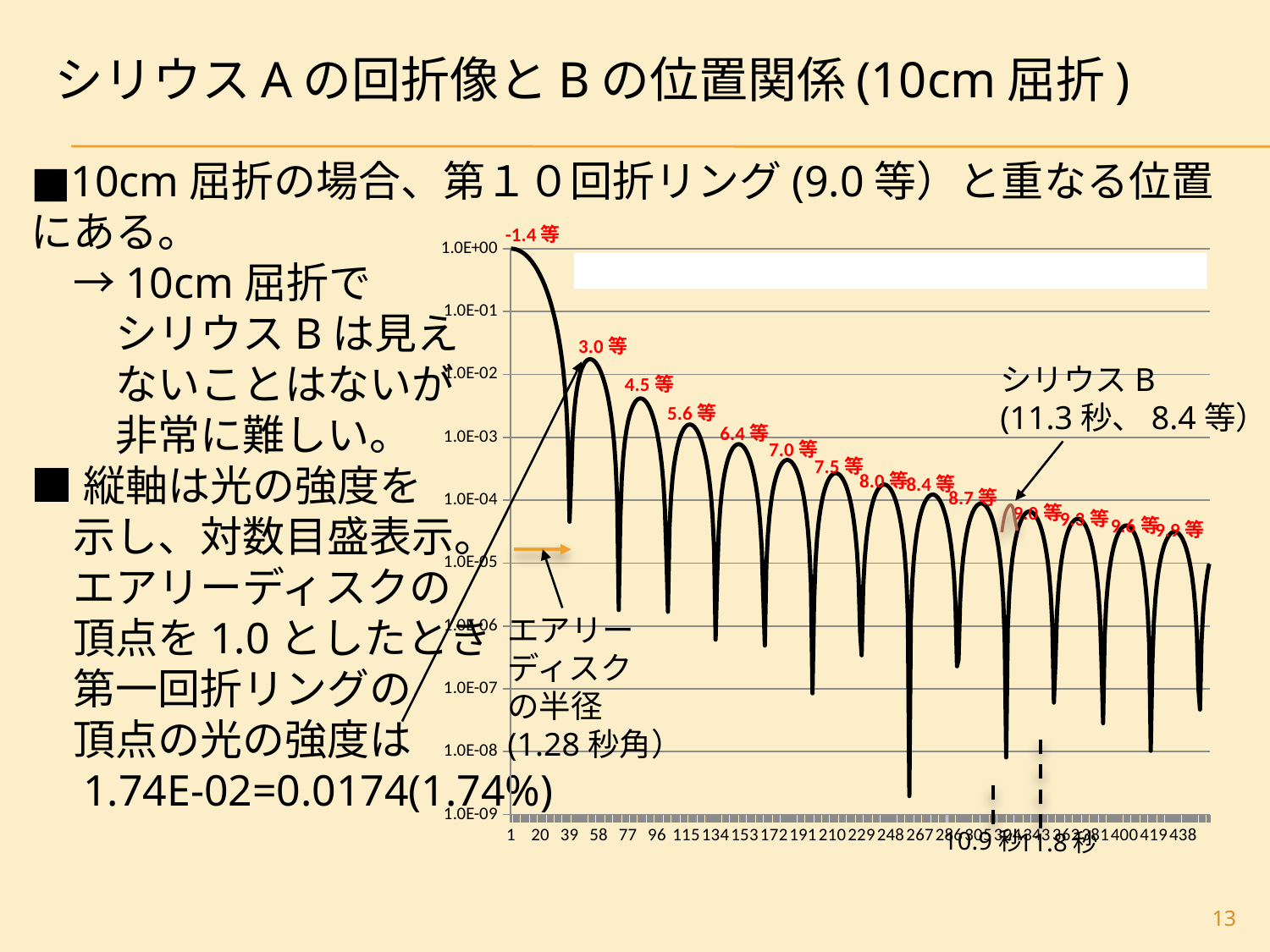
What magnitude label is written at the second peak (the first diffraction ring)? 3.0等 What kind of chart is shown on the slide? line chart How many peaks on the chart carry a red magnitude label? 14 Is the peak value of the first diffraction ring (labelled 3.0等) greater or less than 1.0E-02? greater What is the lowest value shown on the vertical axis? 1.0E-09 According to the annotation on the chart, what are the separation and magnitude of シリウス B? 11.3秒、8.4等 What is the magnitude label (in 等) written at the highest peak at the left of the chart? -1.4等 Is the peak value of the ring labelled 9.0等 greater or less than 1.0E-04? less Is the peak value of the ring labelled 7.0等 greater or less than 1.0E-03? less What is the magnitude label at the last labelled peak on the right of the chart? 9.8等 Do the peak heights of the curve rise or fall moving from left to right along the x axis? fall What magnitude label is written at the third peak of the curve? 4.5等